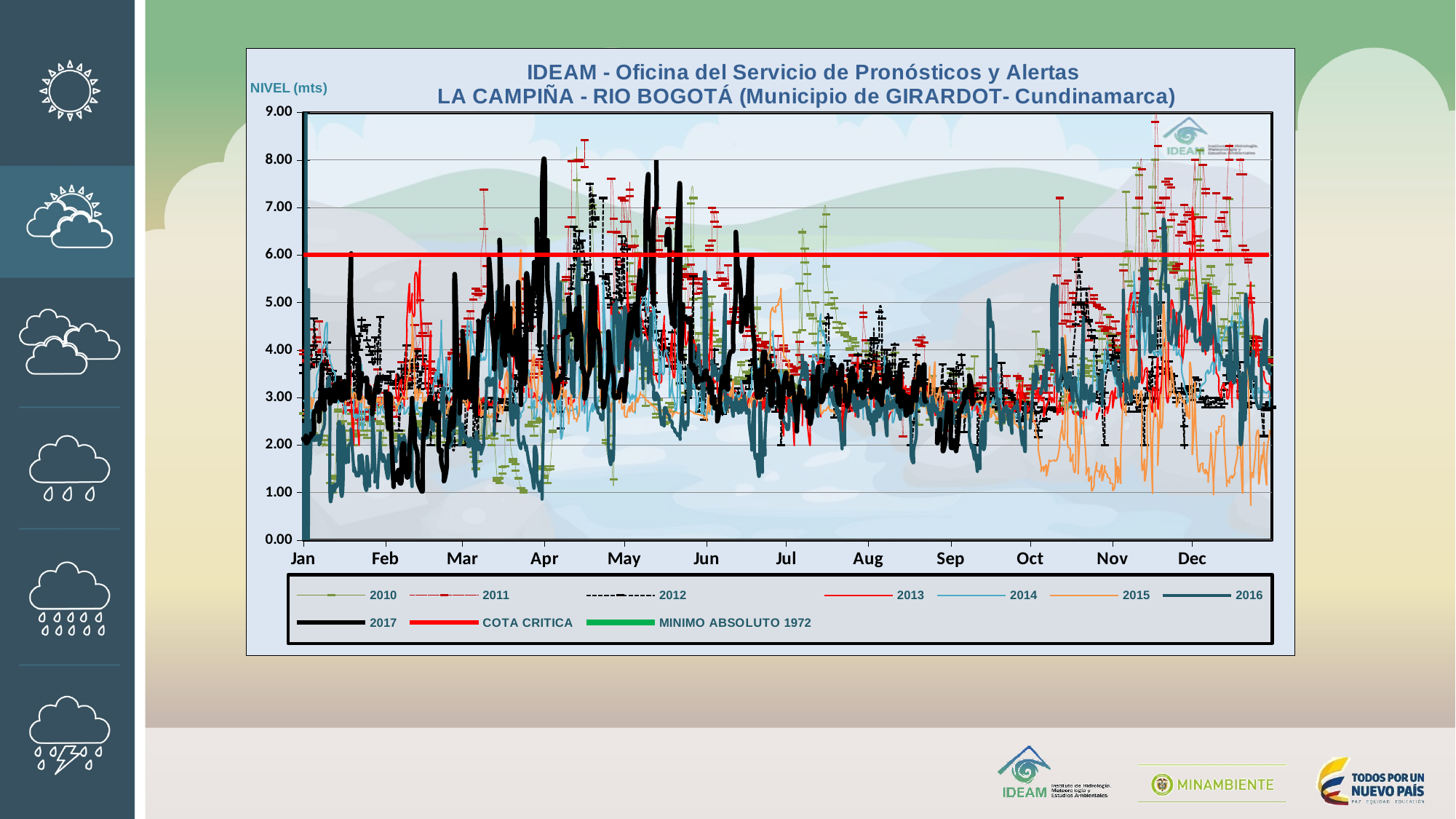
Is the COTA CRITICA line greater or less than 7.00? less Is the COTA CRITICA line greater or less than 5.00? greater What is the lowest value shown on the y axis? 0.00 What is the highest value shown on the y axis? 9.00 What is the value of the COTA CRITICA line? 6.00 How many series does the legend list? 10 Which month is the last label on the x axis? Dec What colour is the COTA CRITICA line? red What is the label of the y axis? NIVEL (mts) Which month is the first label on the x axis? Jan What kind of chart is shown on the slide? line chart How many months are labelled along the x axis? 12